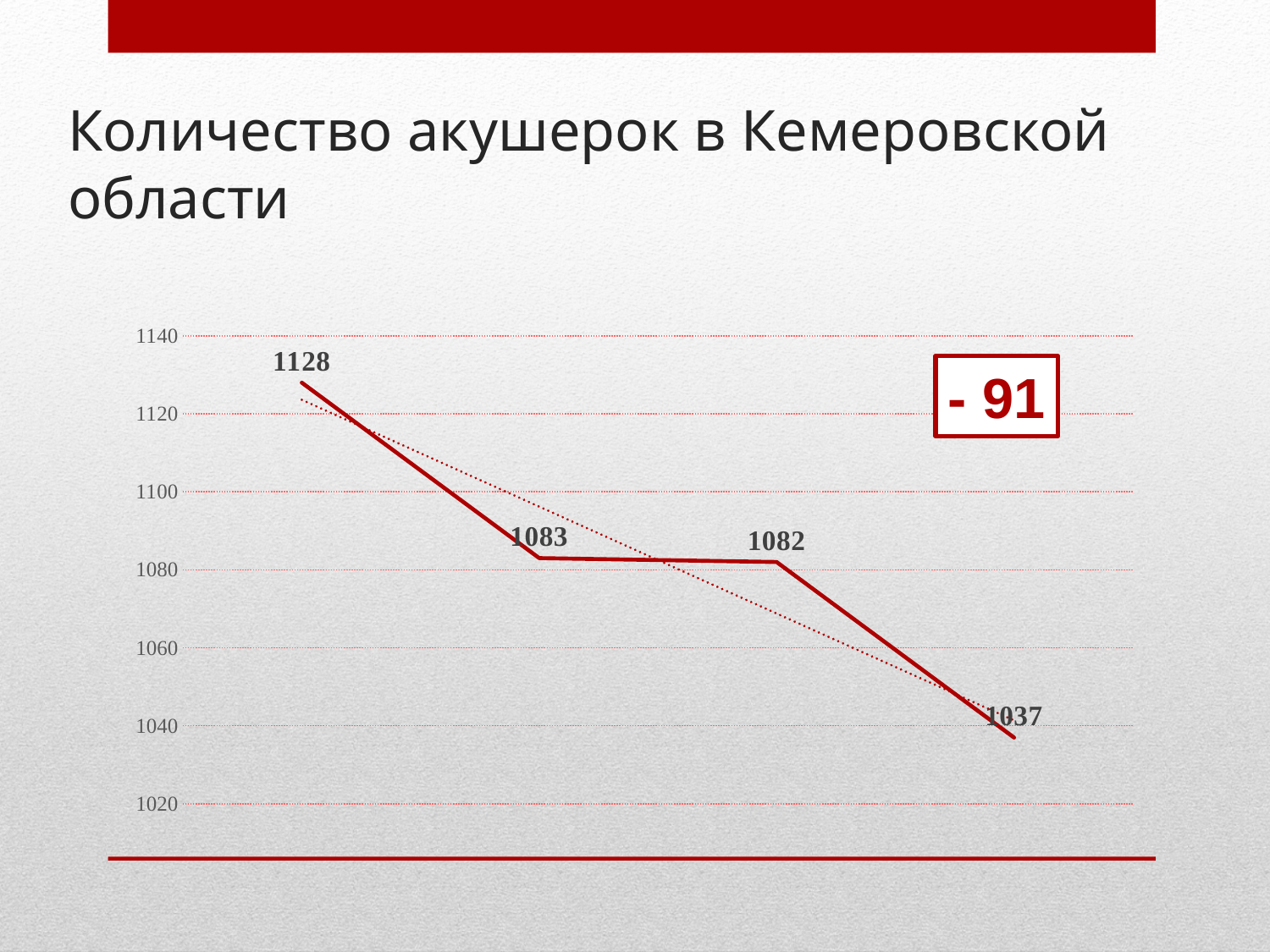
What is the difference between the first point (1128) and the last point (1037)? 91 What is the value of the first (leftmost) point on the line? 1128 How many data points are plotted on the line? 4 What kind of chart is shown on the slide? line chart What is the value of the second point on the line? 1083 What is the value of the third point on the line? 1082 What number is shown in the boxed label at the top right of the chart? - 91 Which point has the highest value? the first point (1128) What is the value of the last (rightmost) point on the line? 1037 Do the values rise or fall from left to right along the x axis? fall Which point has the lowest value? the last point (1037) What is the difference between the second point (1083) and the third point (1082)? 1